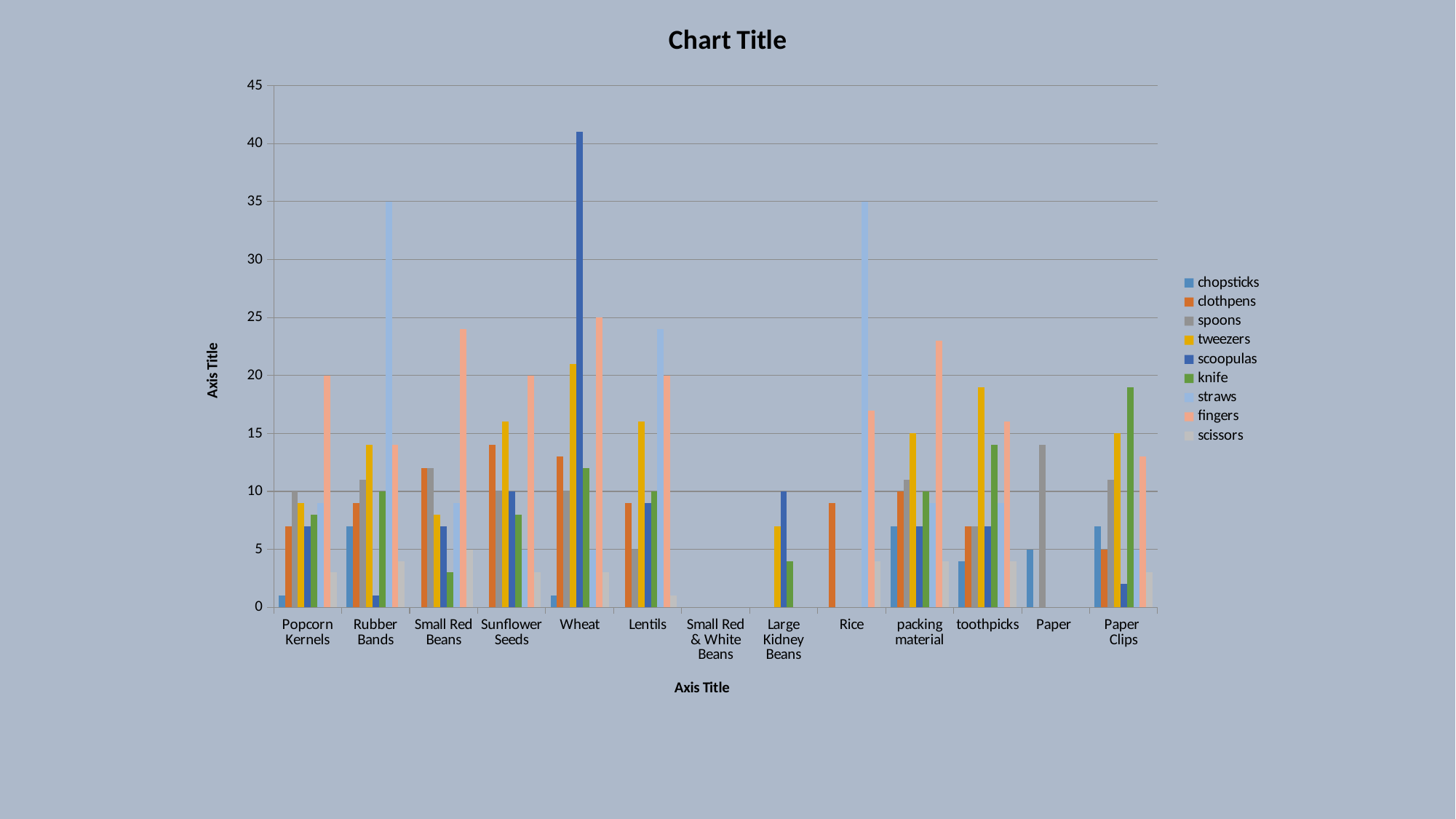
Which series has the tallest bar for Wheat? scoopulas Is the value for clothpens at Rice greater or less than 10? less Is the value for scoopulas at Wheat greater or less than 40? greater Which category contains the tallest bar in the chart? Wheat Is the value for fingers at Small Red Beans greater or less than 20? greater What is the value for fingers at Wheat? 25 What is the title of the chart? Chart Title How many series does the legend list? 9 Which is larger: the value for tweezers at toothpicks or the value for tweezers at Lentils? toothpicks What kind of chart is shown on the slide? bar chart How many categories are shown along the x axis? 13